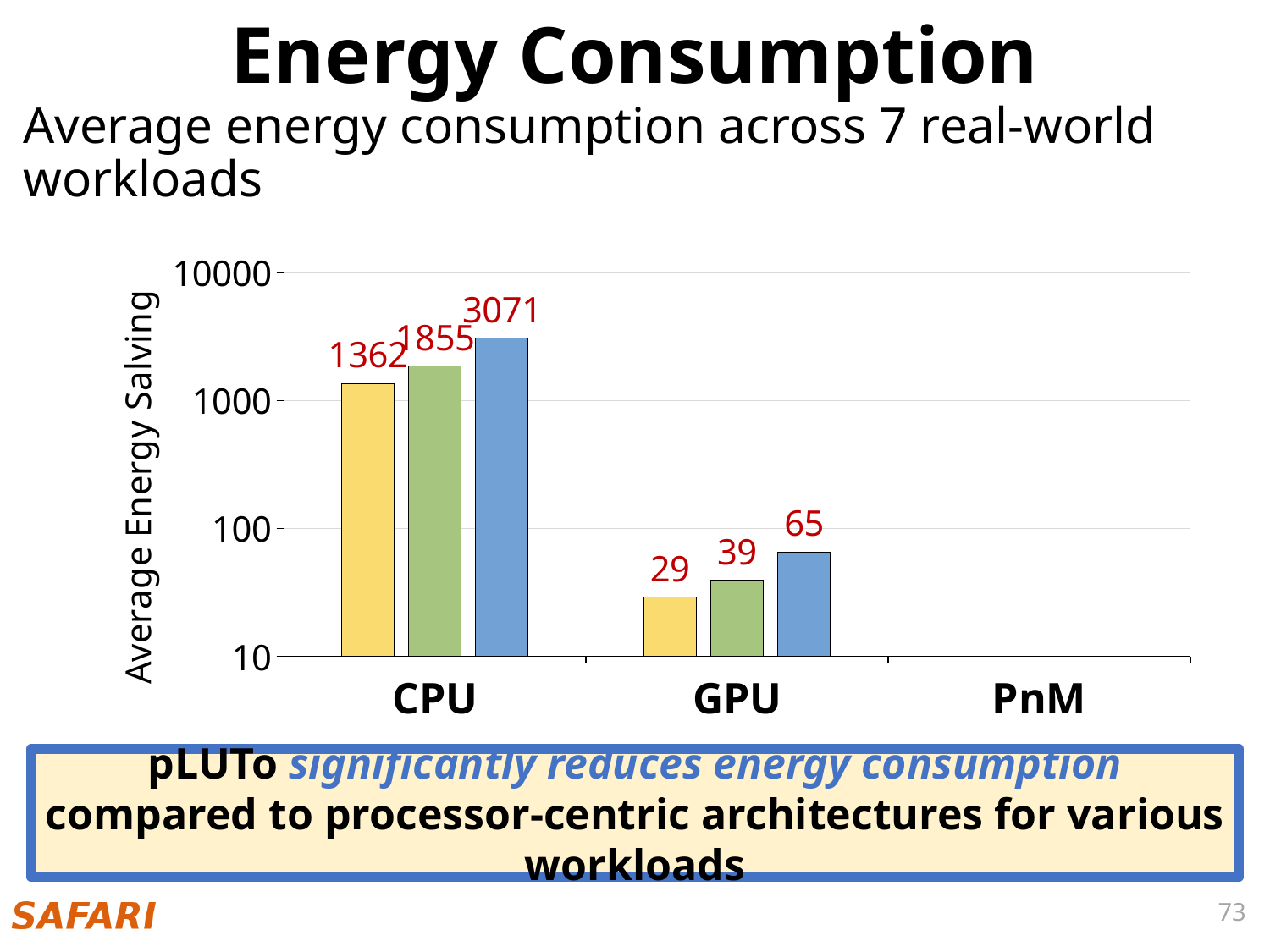
What type of chart is shown on the slide? bar chart What is the value of the yellow bar for GPU? 29 What is the value of the blue bar for CPU? 3071 Is the value of the blue bar for GPU greater or less than 100? less What is the value of the yellow bar for CPU? 1362 Which category has the highest blue bar value? CPU What is the label of the y axis? Average Energy Salving What is the difference between the blue bar and the green bar for GPU? 26 Which is larger: the green bar for CPU or the green bar for GPU? the green bar for CPU What is the value of the green bar for CPU? 1855 What is the value of the blue bar for GPU? 65 What is the difference between the blue bar and the yellow bar for CPU? 1709